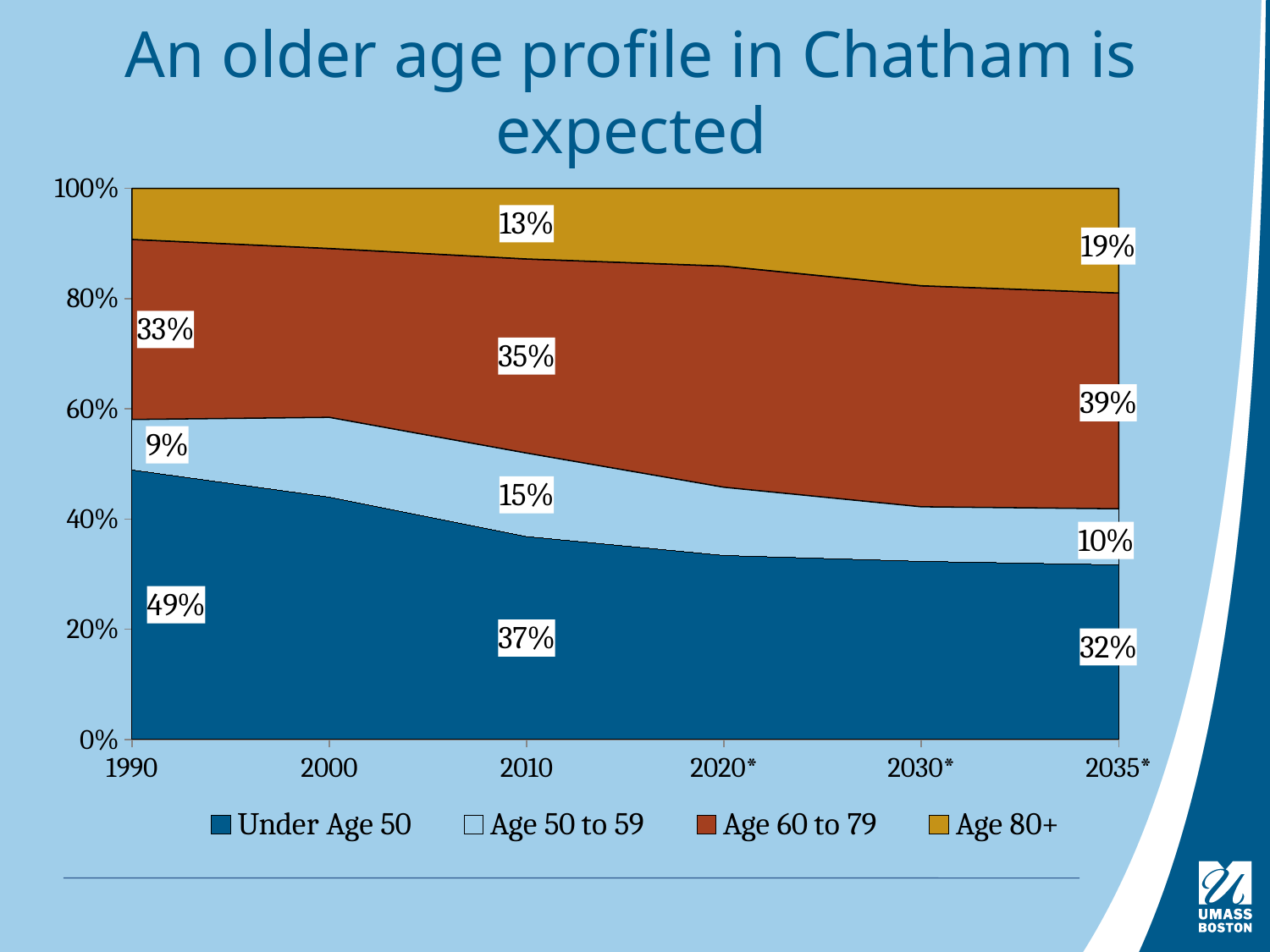
Which age group is shown in the gold colour at the top of the chart? Age 80+ Which is larger in 2010: the Age 60 to 79 share or the Under Age 50 share? Under Age 50 What share of Chatham's population was Under Age 50 in 1990? 49% What share of the population is Age 50 to 59 in 2035*? 10% What share of the population is Age 60 to 79 in 2035*? 39% Does the Age 80+ share rise or fall from 2010 to 2035*? rise What kind of chart is shown on the slide? stacked area chart What is the difference between the Under Age 50 share in 1990 and in 2035*? 17% What share of the population is Age 80+ in 2010? 13% How many series does the legend list? 4 Does the Under Age 50 share rise or fall from 1990 to 2035*? fall How many years are labeled on the x axis? 6